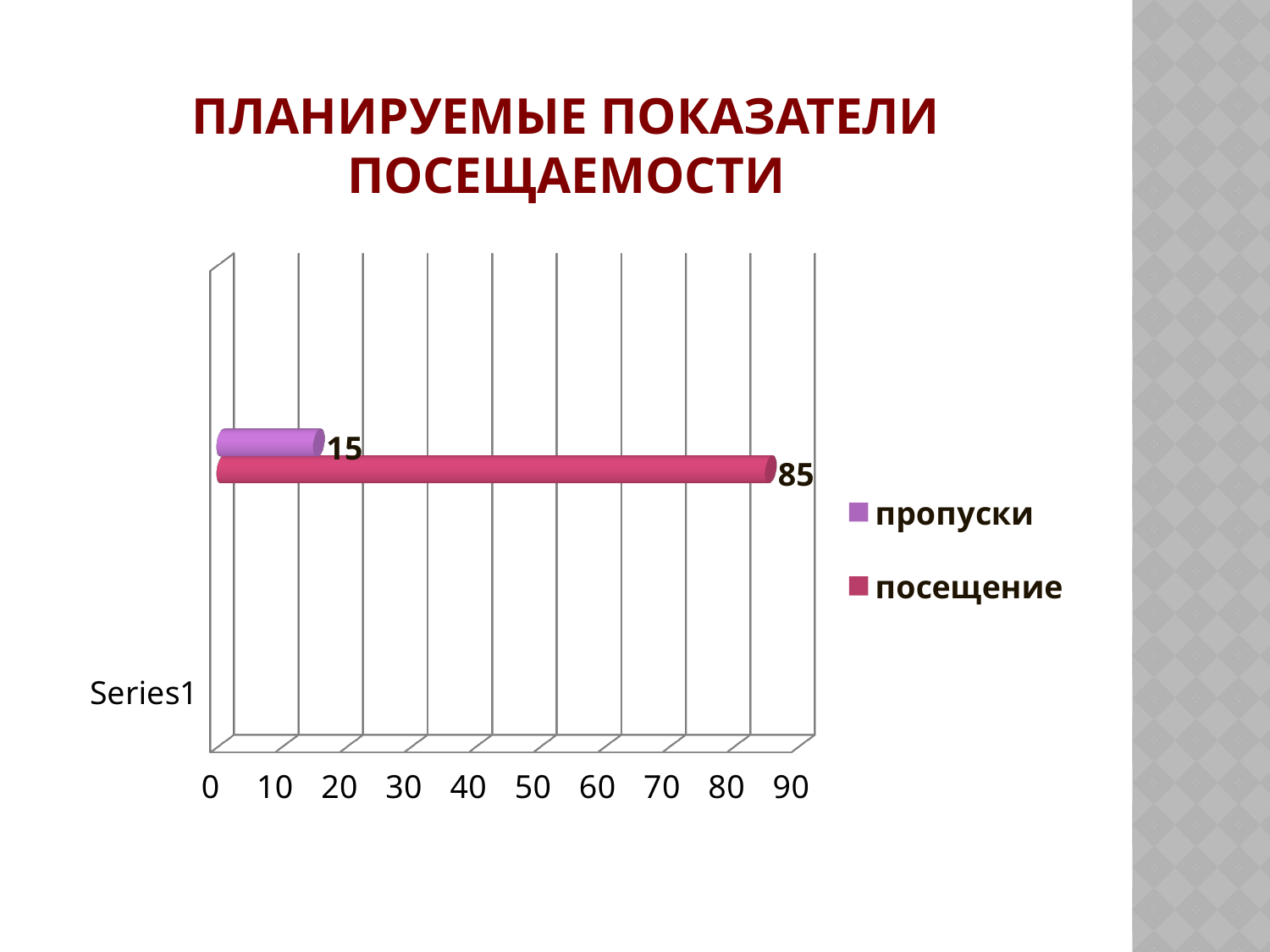
What is the title of the slide? ПЛАНИРУЕМЫЕ ПОКАЗАТЕЛИ ПОСЕЩАЕМОСТИ What is the category label shown on the vertical axis? Series1 What is the value for посещение? 85 What kind of chart is shown on the slide? bar chart How many series does the legend list? 2 What is the highest value shown on the horizontal axis? 90 What is the value for пропуски? 15 Which series has the higher value, пропуски or посещение? посещение What is the difference between the values for посещение and пропуски? 70 Is the value for пропуски greater or less than 20? less Which series has the lowest value? пропуски Is the value for посещение greater or less than 80? greater